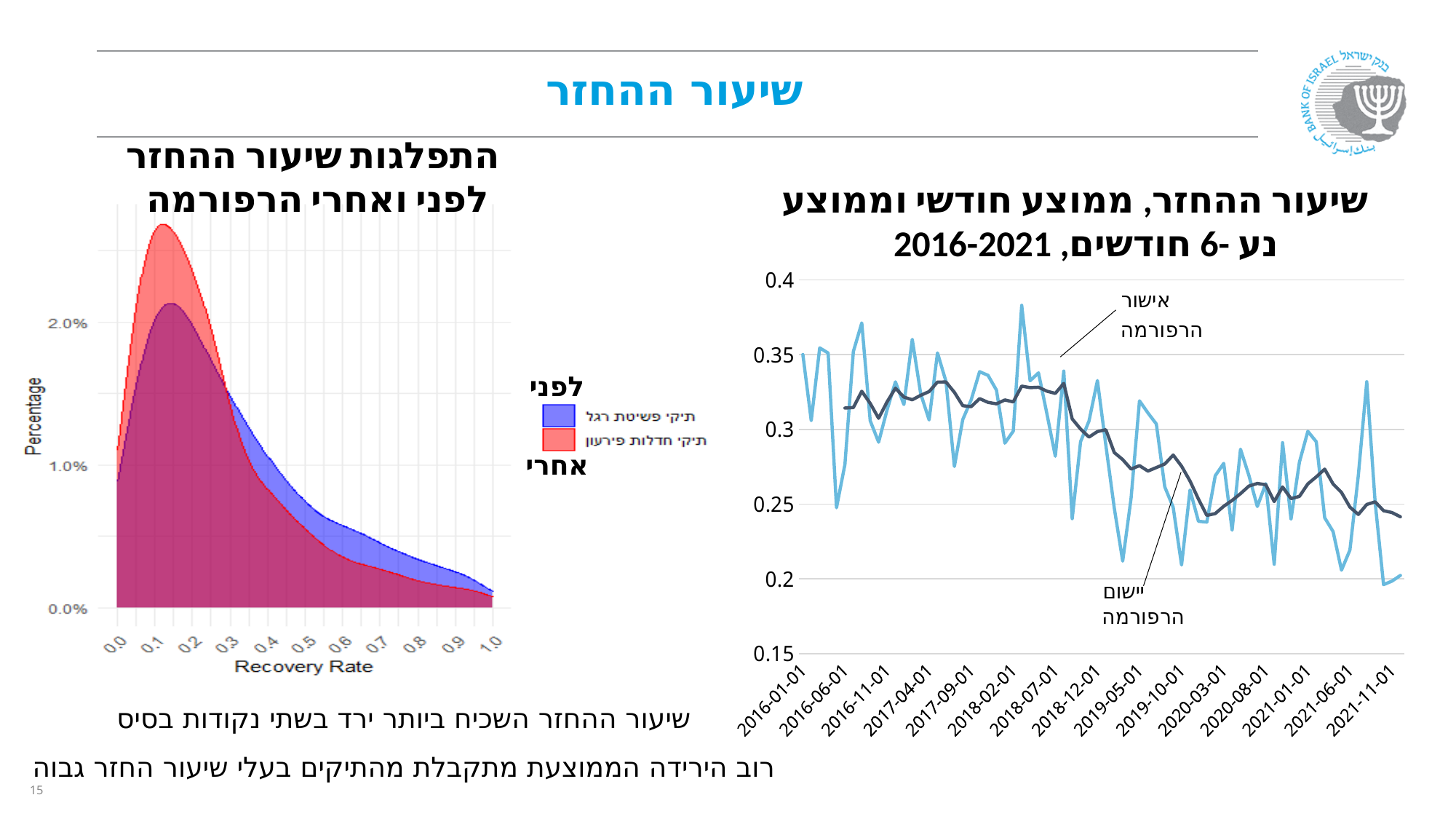
In the right-hand chart, do the values generally rise or fall from 2016 to 2021? fall In the right-hand chart, is the last monthly value at 2021-11-01 greater or less than 0.25? less In the right-hand chart, is the first monthly value at 2016-01-01 greater or less than 0.3? greater What kind of chart is the right-hand chart (שיעור ההחזר, ממוצע חודשי וממוצע נע -6 חודשים, 2016-2021)? line chart What is the label of the horizontal axis in the left-hand chart? Recovery Rate In the left-hand chart, which series has the higher peak: תיקי פשיטת רגל or תיקי חדלות פירעון? תיקי חדלות פירעון What kind of chart is the left-hand chart (התפלגות שיעור ההחזר לפני ואחרי הרפורמה)? area chart In the right-hand chart, what is the lowest value shown on the vertical axis? 0.15 In the left-hand chart, is the peak of the תיקי חדלות פירעון series greater or less than 2.0%? greater How many series does the legend of the left-hand chart list? 2 In the left-hand chart, which colour represents תיקי פשיטת רגל? blue